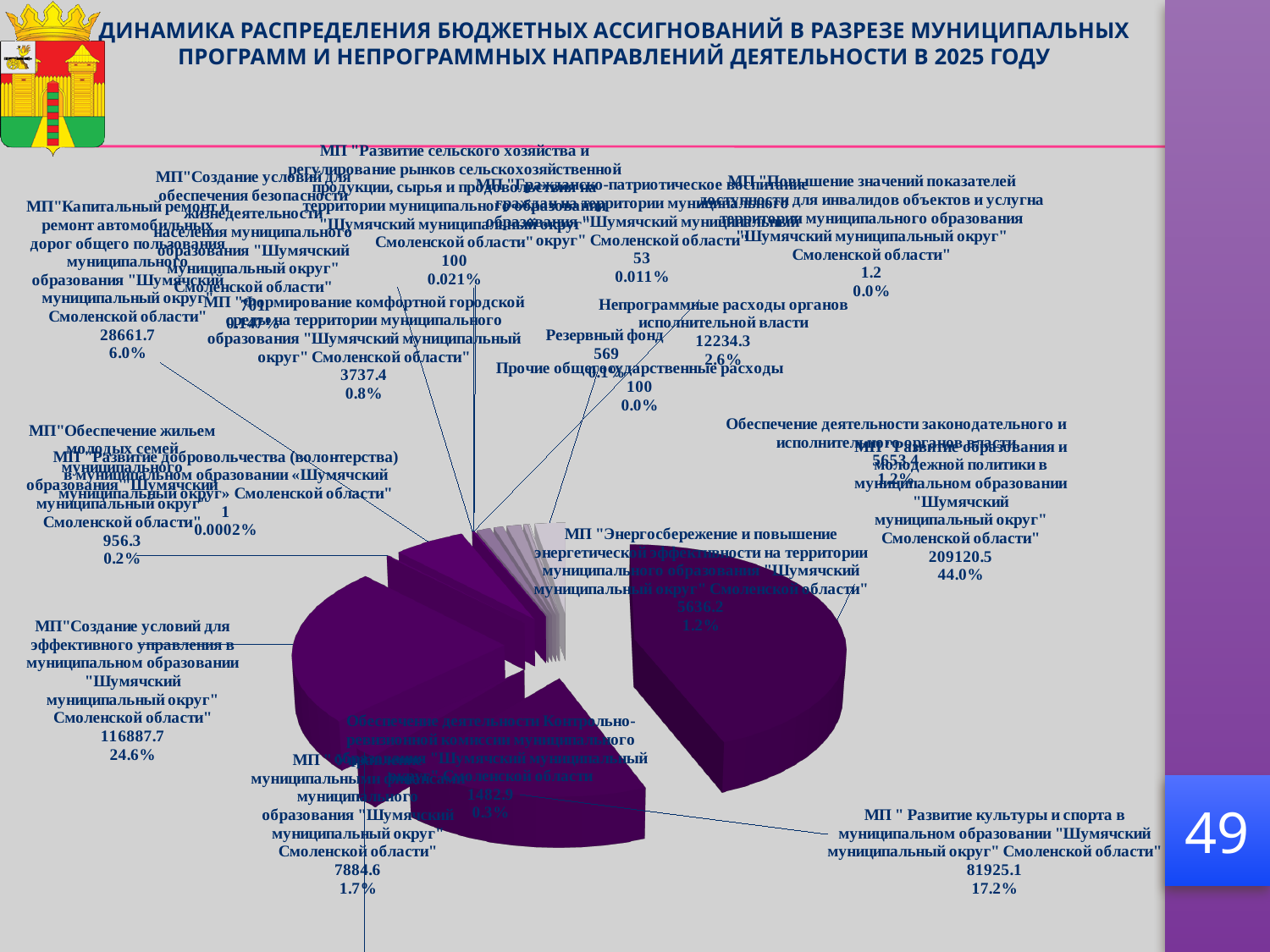
What is the value shown for МП "Создание условий для эффективного управления"? 116887.7 What year does the chart title say the budget allocation dynamics refer to? 2025 What share of the pie does МП "Развитие культуры и спорта" account for? 17.2% Which is larger: the value for МП "Капитальный ремонт и ремонт автомобильных дорог" or for Непрограммные расходы органов исполнительной власти? МП "Капитальный ремонт и ремонт автомобильных дорог" What is the value shown for МП "Капитальный ремонт и ремонт автомобильных дорог общего пользования"? 28661.7 What is the value shown for Непрограммные расходы органов исполнительной власти? 12234.3 What kind of chart is shown on the slide? pie chart What is the value shown for Резервный фонд? 569 What share of the pie does МП "Развитие образования и молодежной политики" account for? 44.0% What is the difference between the values for МП "Развитие образования и молодежной политики" (209120.5) and МП "Создание условий для эффективного управления" (116887.7)? 92232.8 What share of the pie does МП "Управление финансами" account for? 1.7% Which category has the largest slice of the pie? МП "Развитие образования и молодежной политики"